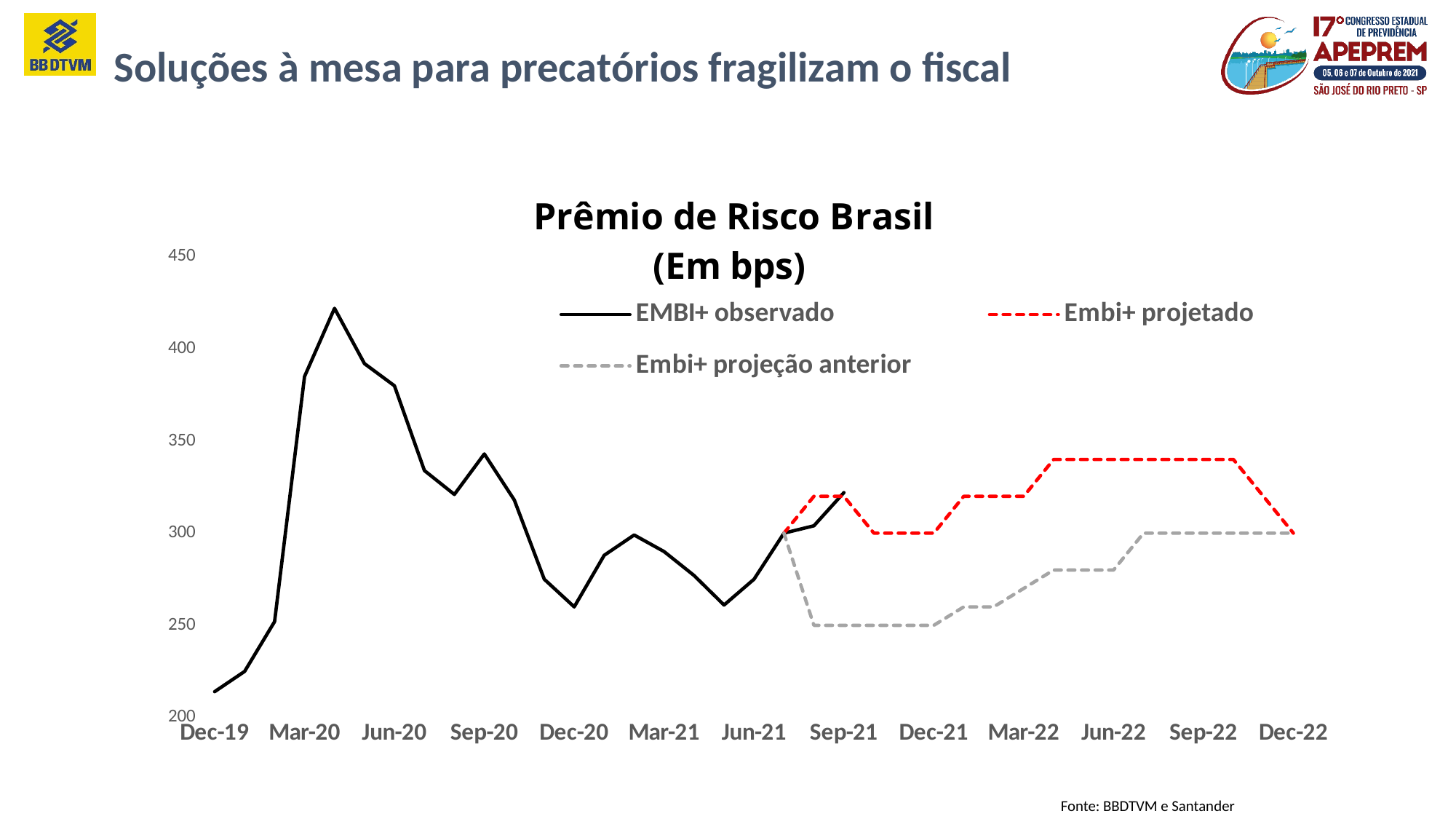
Is the value of Embi+ projetado at Jun-22 greater or less than 350? less Does the Embi+ projetado line rise or fall between Sep-22 and Dec-22? fall Does the EMBI+ observado line rise or fall between Dec-19 and Mar-20? rise How many date labels are shown on the x axis? 13 What kind of chart is shown on the slide? line chart Is the value of EMBI+ observado at Dec-20 greater or less than 300? less Is the peak value of EMBI+ observado around Mar-20 greater or less than 400? greater At Jun-22, which series is higher: Embi+ projetado or Embi+ projeção anterior? Embi+ projetado How many series does the legend list? 3 What is the title of the chart? Prêmio de Risco Brasil (Em bps) Which series is drawn as a red dashed line? Embi+ projetado